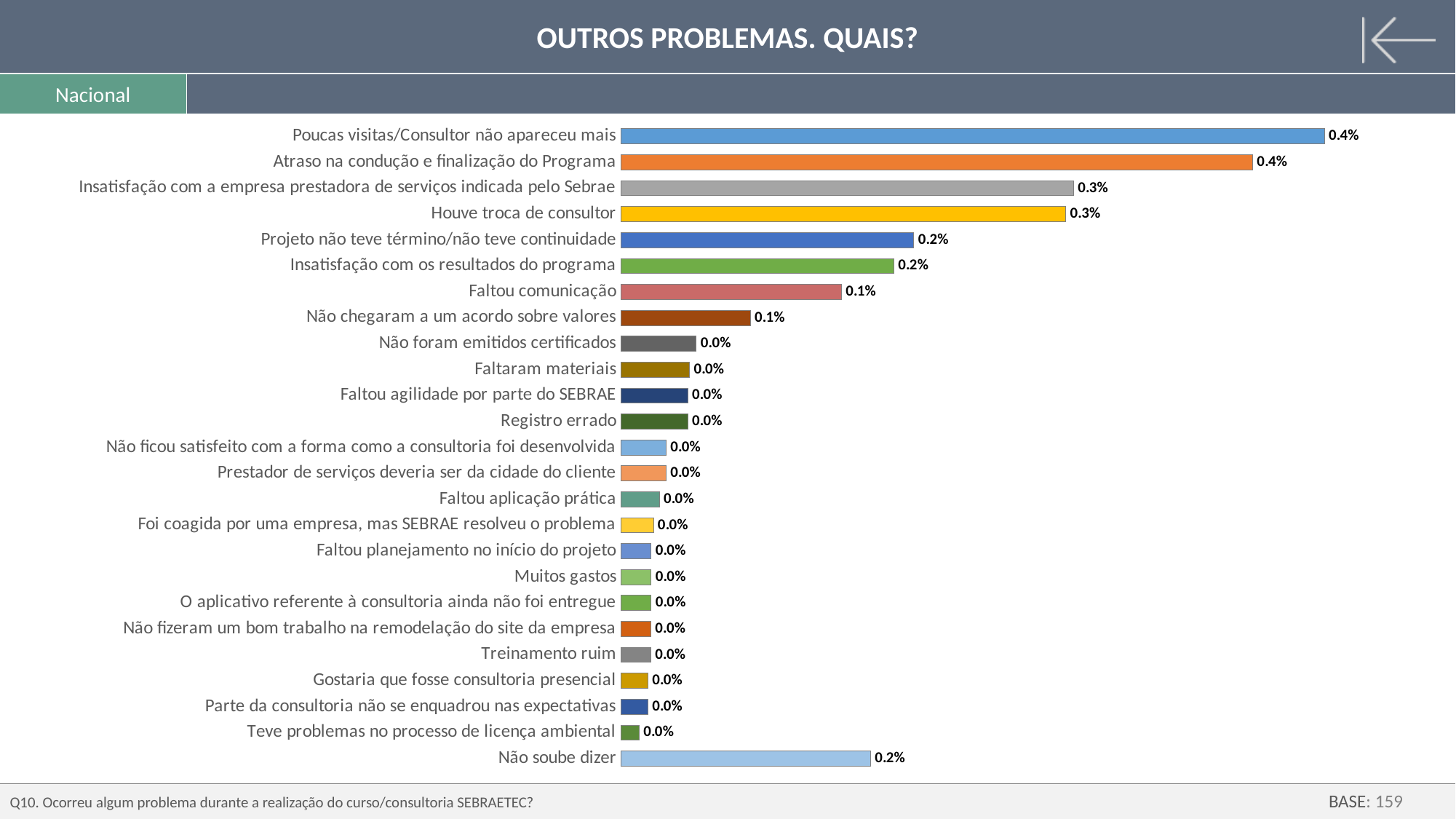
How many categories are plotted in the chart? 25 What is the value for "Não soube dizer"? 0.2% What is the difference between the value for "Atraso na condução e finalização do Programa" and the value for "Insatisfação com os resultados do programa"? 0.2% What is the value for "Registro errado"? 0.0% What is the title of the slide containing the chart? OUTROS PROBLEMAS. QUAIS? What kind of chart is shown on the slide? bar chart What base (number of respondents) is shown at the bottom of the slide? 159 What is the value for "Houve troca de consultor"? 0.3% Which is larger, the value for "Houve troca de consultor" or the value for "Faltou comunicação"? Houve troca de consultor What is the value for "Poucas visitas/Consultor não apareceu mais"? 0.4% What is the value for "Faltou comunicação"? 0.1% Which is larger, the value for "Não soube dizer" or the value for "Treinamento ruim"? Não soube dizer